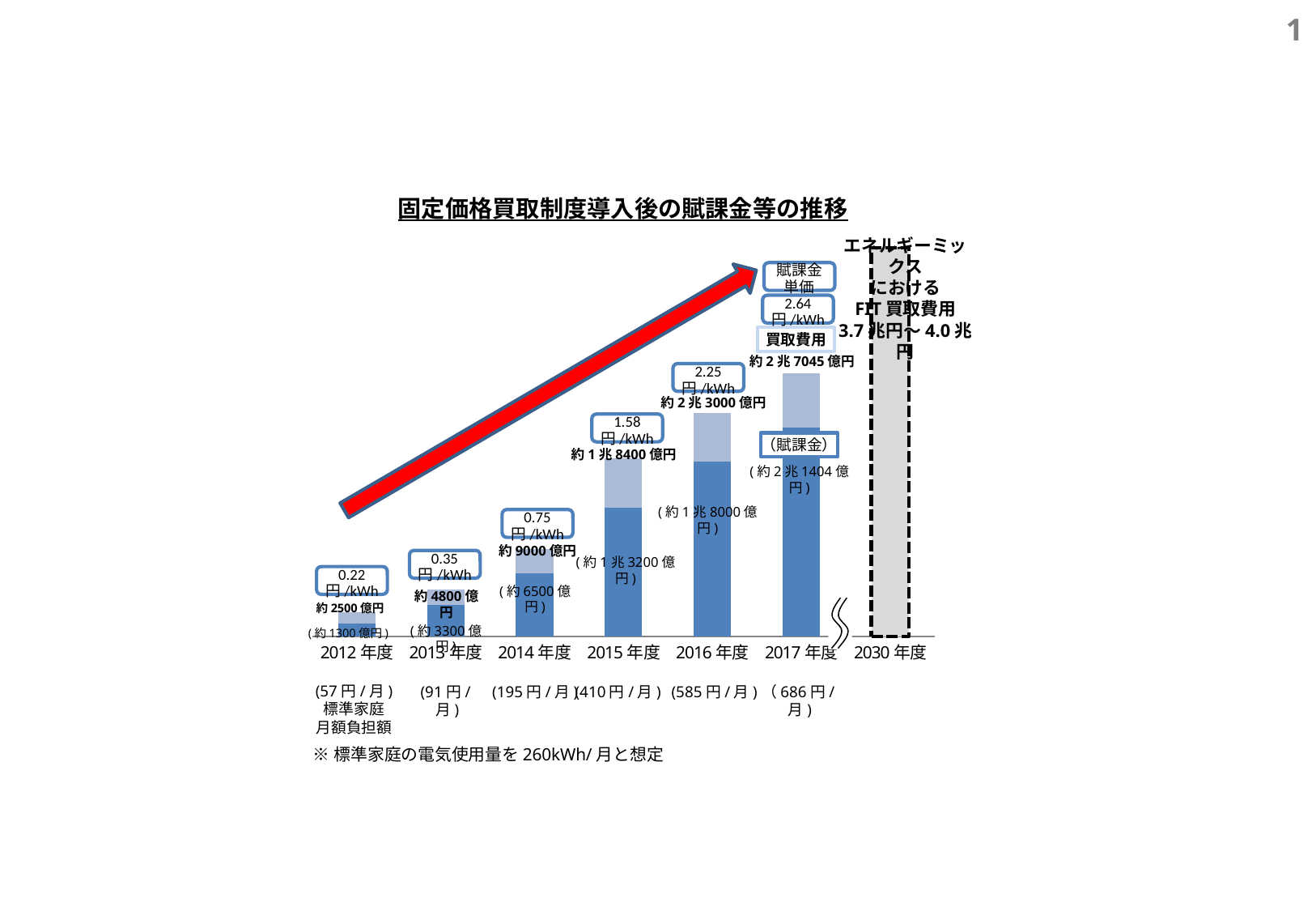
What type of chart is shown on the slide? bar chart What is the title of the chart? 固定価格買取制度導入後の賦課金等の推移 What is the standard household monthly burden shown for 2014年度? 195円/月 What is the purchase cost (買取費用) shown for 2015年度? 約1兆8400億円 Which fiscal year has the highest surcharge unit price among the plotted bars? 2017年度 What is the surcharge amount (賦課金) shown for 2016年度? 約1兆8000億円 Do the bar heights rise or fall from 2012年度 to 2017年度? rise What is the surcharge unit price (賦課金単価) shown for 2012年度? 0.22円/kWh By how much did the surcharge unit price increase from 2016年度 to 2017年度? 0.39円/kWh What is the surcharge unit price (賦課金単価) shown for 2017年度? 2.64円/kWh How many fiscal years have bars with data plotted (excluding the 2030年度 placeholder)? 6 Which fiscal year has the lowest purchase cost (買取費用) among the plotted bars? 2012年度